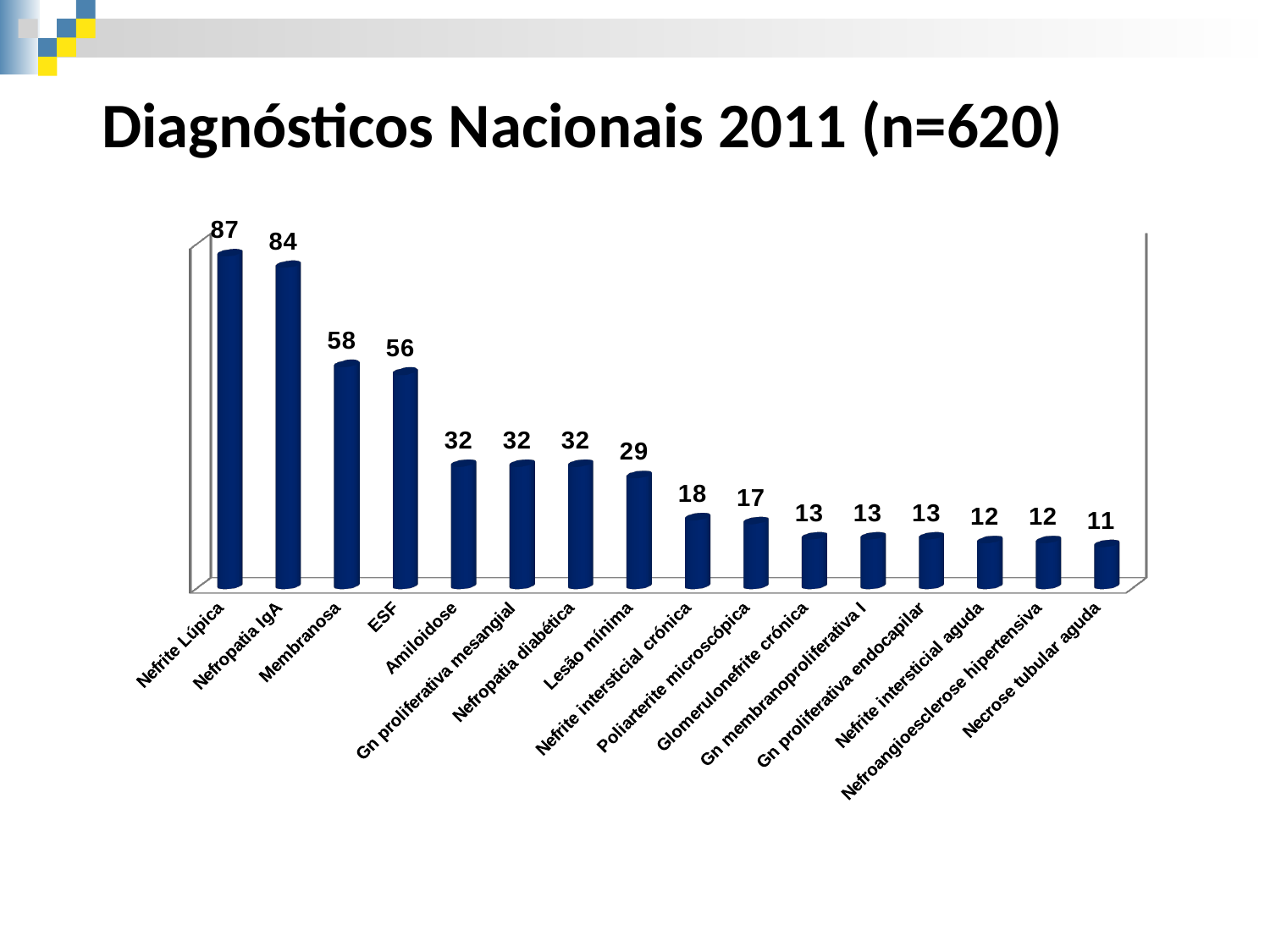
What is the value for Membranosa? 58 What is the title of the chart? Diagnósticos Nacionais 2011 (n=620) Which category has the lowest value? Necrose tubular aguda How many categories are shown in the chart? 16 What is the difference between the values for Membranosa and ESF? 2 What is the value for Lesão mínima? 29 What is the difference between the values for Nefrite Lúpica and Nefropatia IgA? 3 What is the value for Poliarterite microscópica? 17 What kind of chart is shown on the slide? Bar chart Which category has the highest value? Nefrite Lúpica What is the value for Nefrite Lúpica? 87 Which is larger, the value for Nefrite intersticial crónica or the value for Poliarterite microscópica? Nefrite intersticial crónica